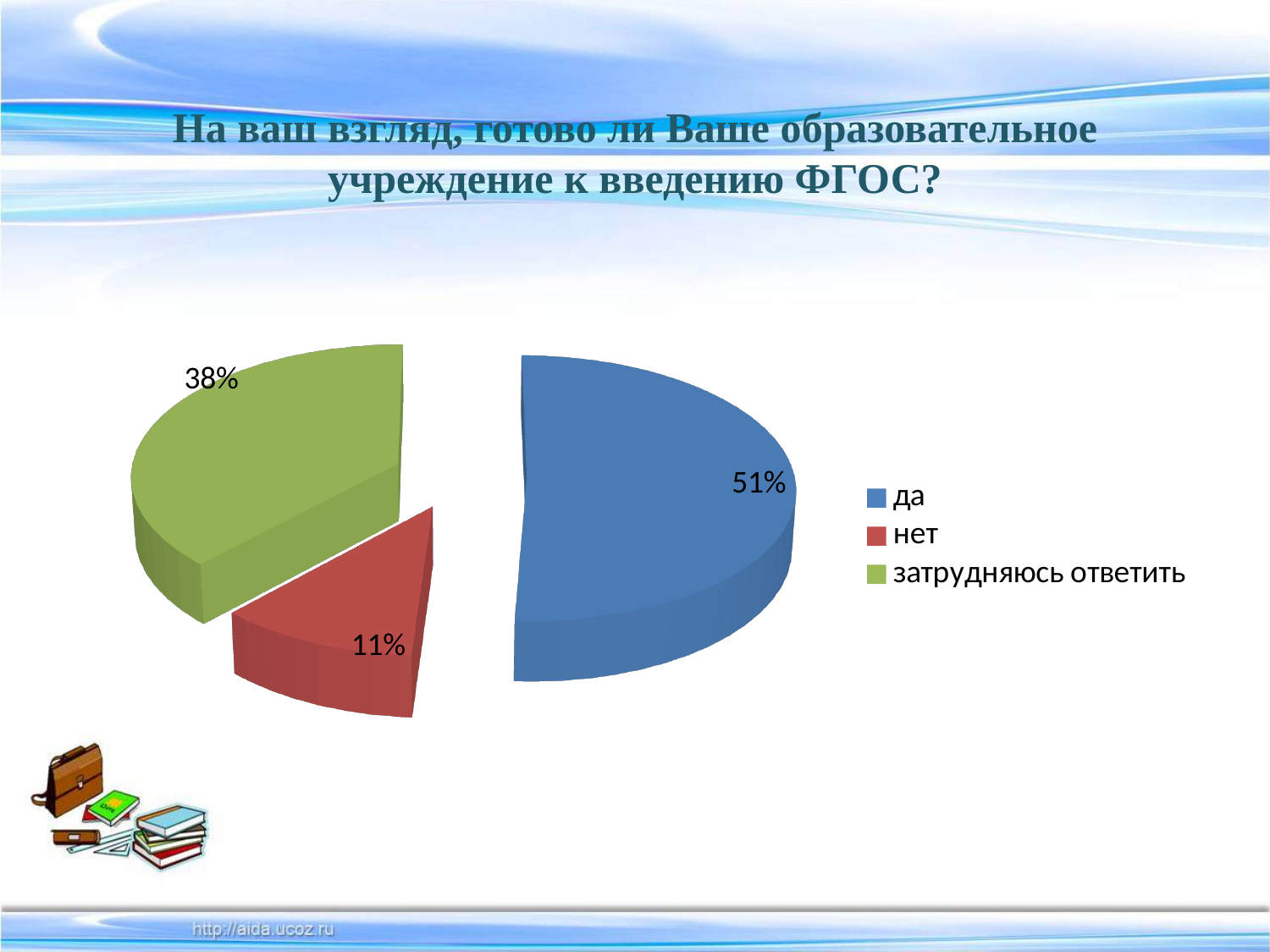
Which is larger, the share for "да" or the share for "затрудняюсь ответить"? да How many slices does the pie chart have? 3 What is the difference in percentage points between "затрудняюсь ответить" and "нет"? 27 What percentage of respondents answered "нет"? 11% What kind of chart is shown on the slide? pie chart What percentage of respondents answered "затрудняюсь ответить"? 38% What colour is the slice for "затрудняюсь ответить"? green Which answer has the smallest share of the pie? нет What is the difference in percentage points between "да" and "нет"? 40 Which answer has the largest share of the pie? да How many entries does the legend list? 3 What percentage of respondents answered "да"? 51%